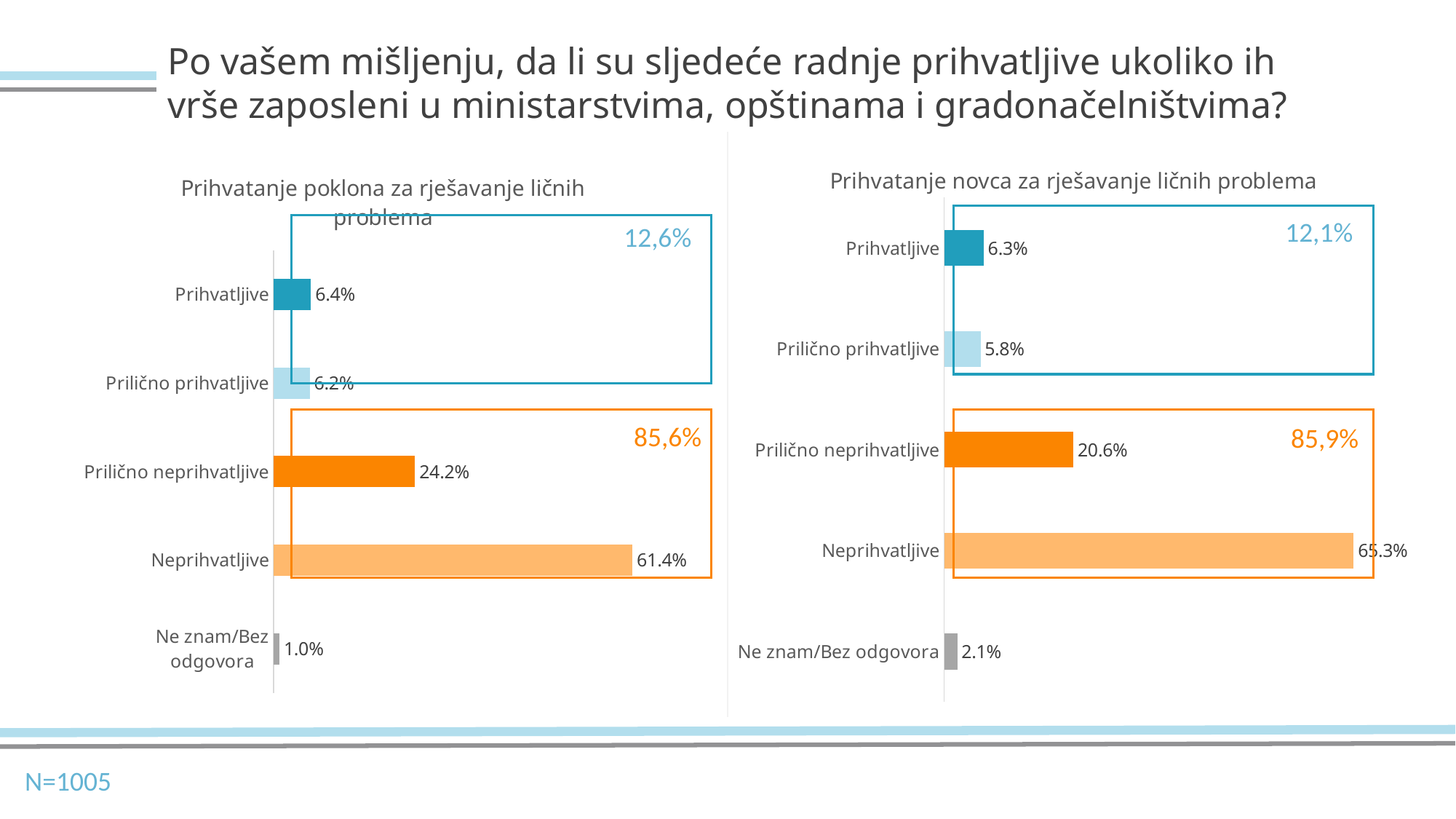
In the chart titled 'Prihvatanje poklona za rješavanje ličnih problema', what is the value for 'Neprihvatljive'? 61.4% In the chart titled 'Prihvatanje novca za rješavanje ličnih problema', what is the value for 'Prilično neprihvatljive'? 20.6% In the chart titled 'Prihvatanje novca za rješavanje ličnih problema', what is the difference between 'Prihvatljive' and 'Prilično prihvatljive'? 0.5% What type of chart is used for 'Prihvatanje poklona za rješavanje ličnih problema'? Bar chart In the chart titled 'Prihvatanje poklona za rješavanje ličnih problema', which category has the lowest value? Ne znam/Bez odgovora Which is larger: 'Neprihvatljive' in the left chart (Prihvatanje poklona) or 'Neprihvatljive' in the right chart (Prihvatanje novca)? Right chart (Prihvatanje novca), 65.3% In the chart titled 'Prihvatanje novca za rješavanje ličnih problema', what combined percentage is shown in the orange box for the unacceptable responses? 85,9% In the chart titled 'Prihvatanje poklona za rješavanje ličnih problema', what combined percentage is shown in the blue box for the acceptable responses? 12,6% In the chart titled 'Prihvatanje novca za rješavanje ličnih problema', which category has the highest value? Neprihvatljive How many categories are shown in the chart titled 'Prihvatanje novca za rješavanje ličnih problema'? 5 In the chart titled 'Prihvatanje poklona za rješavanje ličnih problema', what is the difference between 'Neprihvatljive' and 'Prilično neprihvatljive'? 37.2% In the chart titled 'Prihvatanje poklona za rješavanje ličnih problema', what is the value for 'Ne znam/Bez odgovora'? 1.0%